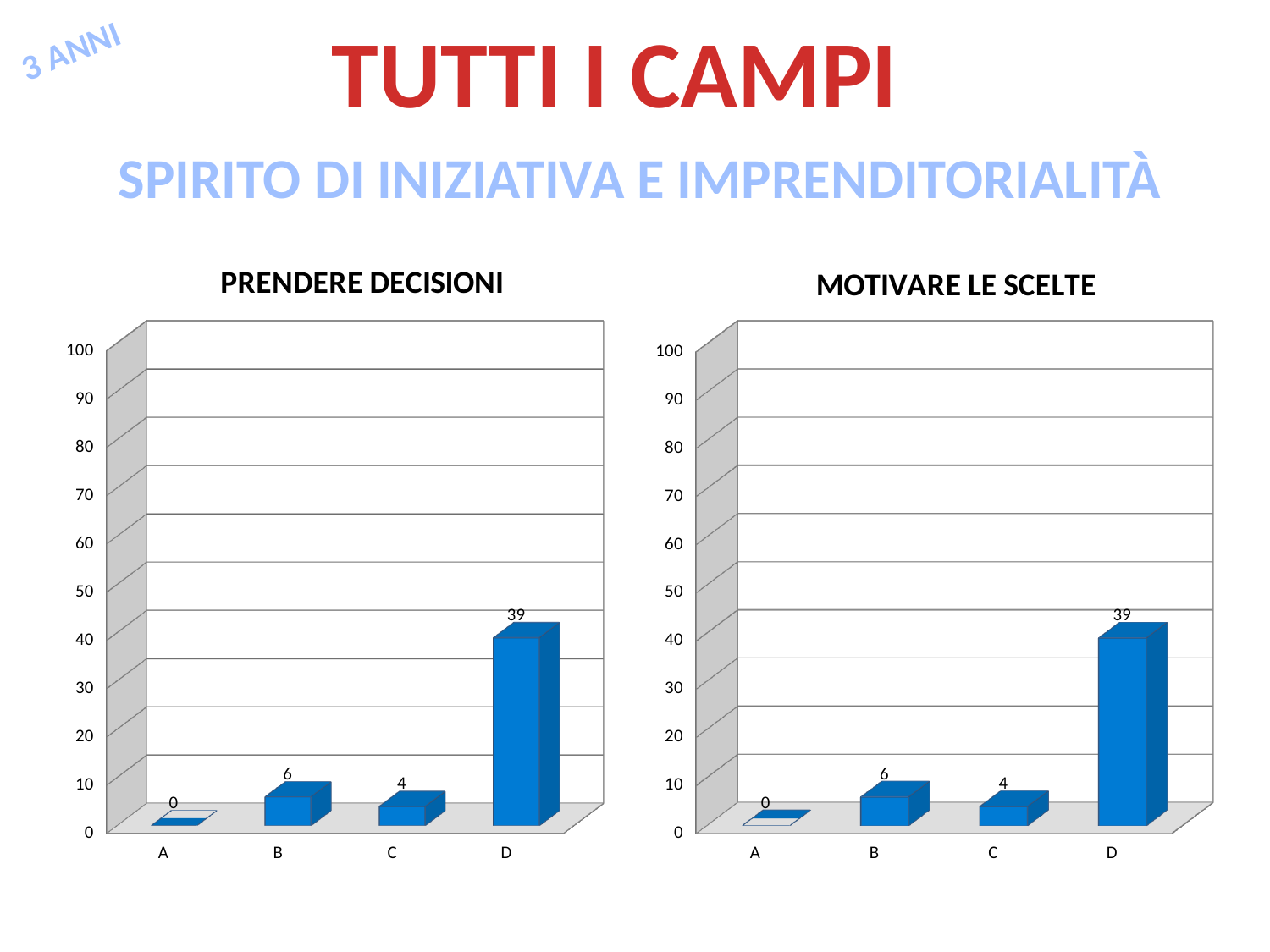
In the PRENDERE DECISIONI chart, what is the value for D? 39 In the MOTIVARE LE SCELTE chart, what is the value for B? 6 In the PRENDERE DECISIONI chart, which category has the lowest value? A In the MOTIVARE LE SCELTE chart, which is larger, the value for B or the value for C? B How many categories are shown in the MOTIVARE LE SCELTE chart? 4 What is the title of the chart on the right side of the slide? MOTIVARE LE SCELTE In the PRENDERE DECISIONI chart, is the value for D greater or less than 50? less In the PRENDERE DECISIONI chart, what is the value for A? 0 In the PRENDERE DECISIONI chart, what is the difference between the values for D and B? 33 In the MOTIVARE LE SCELTE chart, which category has the highest value? D What kind of chart is the PRENDERE DECISIONI chart? bar chart In the MOTIVARE LE SCELTE chart, what is the difference between the values for B and C? 2